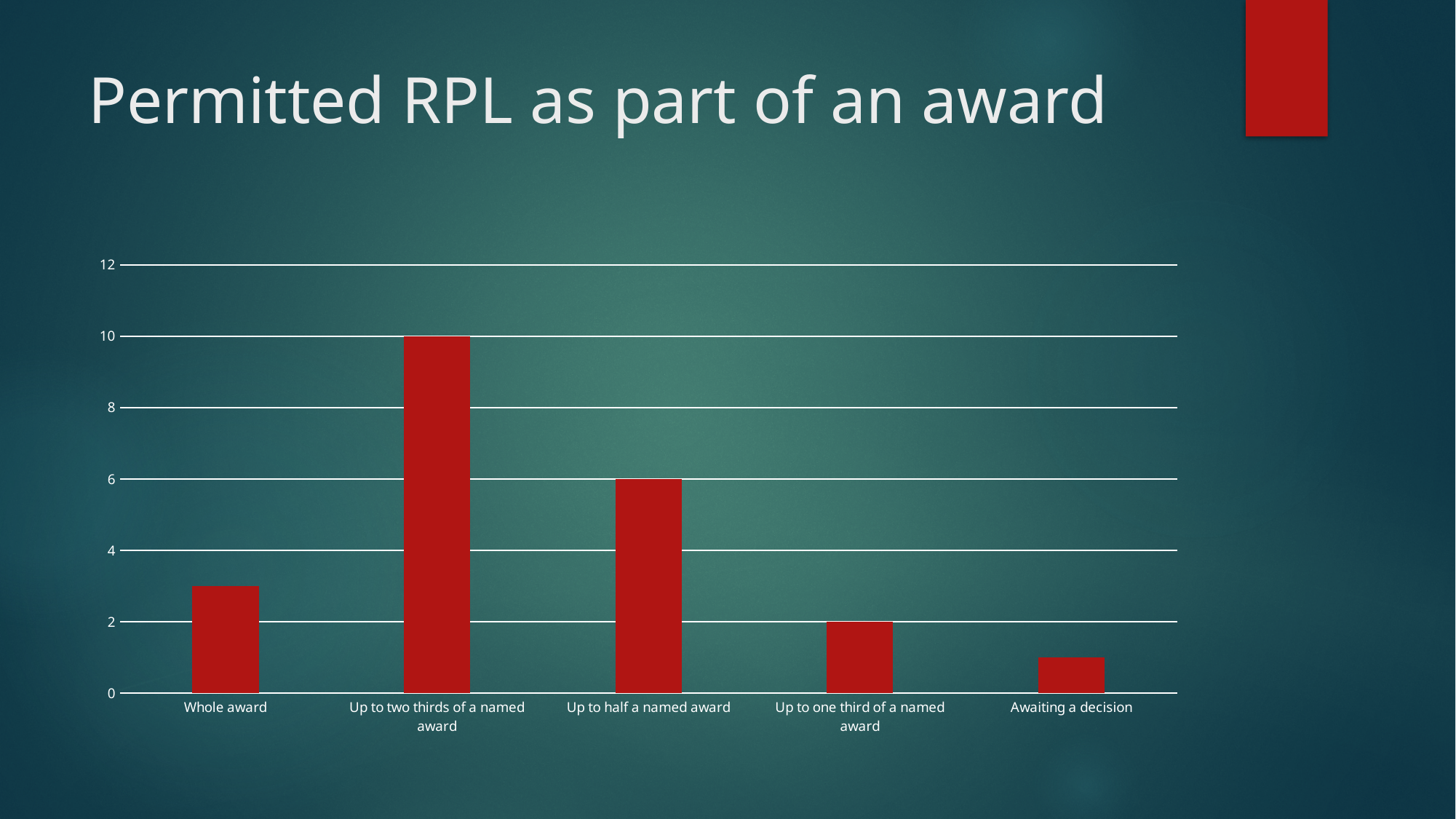
Is the value for 'Whole award' greater or less than 4? less What type of chart is shown on the slide? Bar chart What is the difference between the values for 'Up to two thirds of a named award' and 'Up to half a named award'? 4 What is the value for 'Up to half a named award'? 6 Which is larger, the value for 'Whole award' or the value for 'Up to half a named award'? Up to half a named award What is the value for 'Up to two thirds of a named award'? 10 How many categories are shown on the x axis of the chart? 5 What is the value for 'Up to one third of a named award'? 2 Which category has the lowest value? Awaiting a decision Is the value for 'Awaiting a decision' greater or less than 2? less What is the title of the chart on the slide? Permitted RPL as part of an award Which category has the highest value? Up to two thirds of a named award